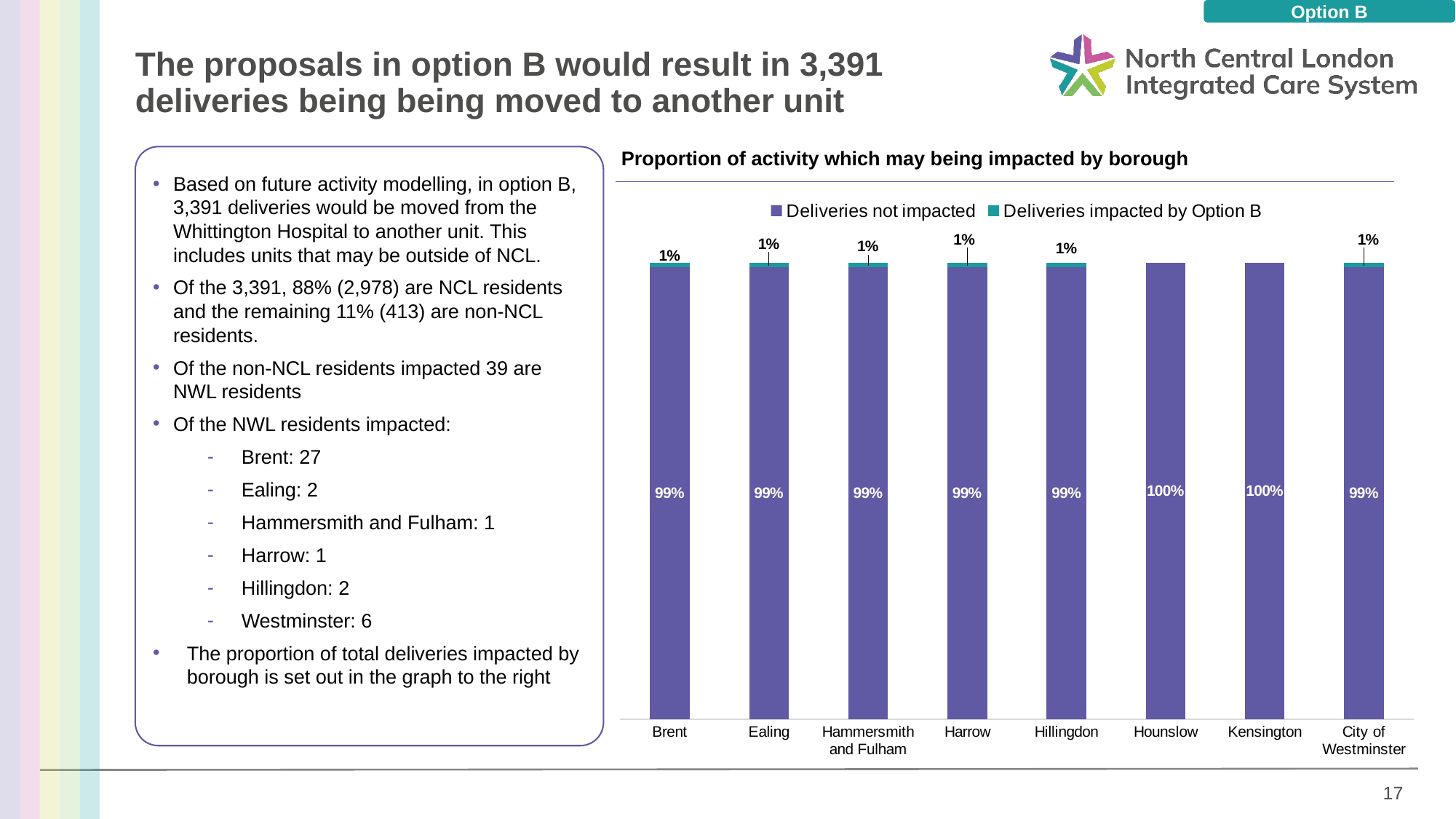
What is the value of 'Deliveries impacted by Option B' for Ealing? 1% What is the value of 'Deliveries not impacted' for Brent? 99% What is the value of 'Deliveries not impacted' for Kensington? 100% What is the difference between the 'Deliveries not impacted' values for Hounslow and Harrow? 1% What is the title of the chart? Proportion of activity which may being impacted by borough What is the value of 'Deliveries impacted by Option B' for City of Westminster? 1% How many boroughs are shown on the x axis of the chart? 8 What kind of chart is shown on the slide? Stacked bar chart Which series is shown in purple in the chart? Deliveries not impacted Which boroughs show 100% for 'Deliveries not impacted'? Hounslow and Kensington How many series does the chart legend list? 2 What is the value of 'Deliveries not impacted' for Hounslow? 100%